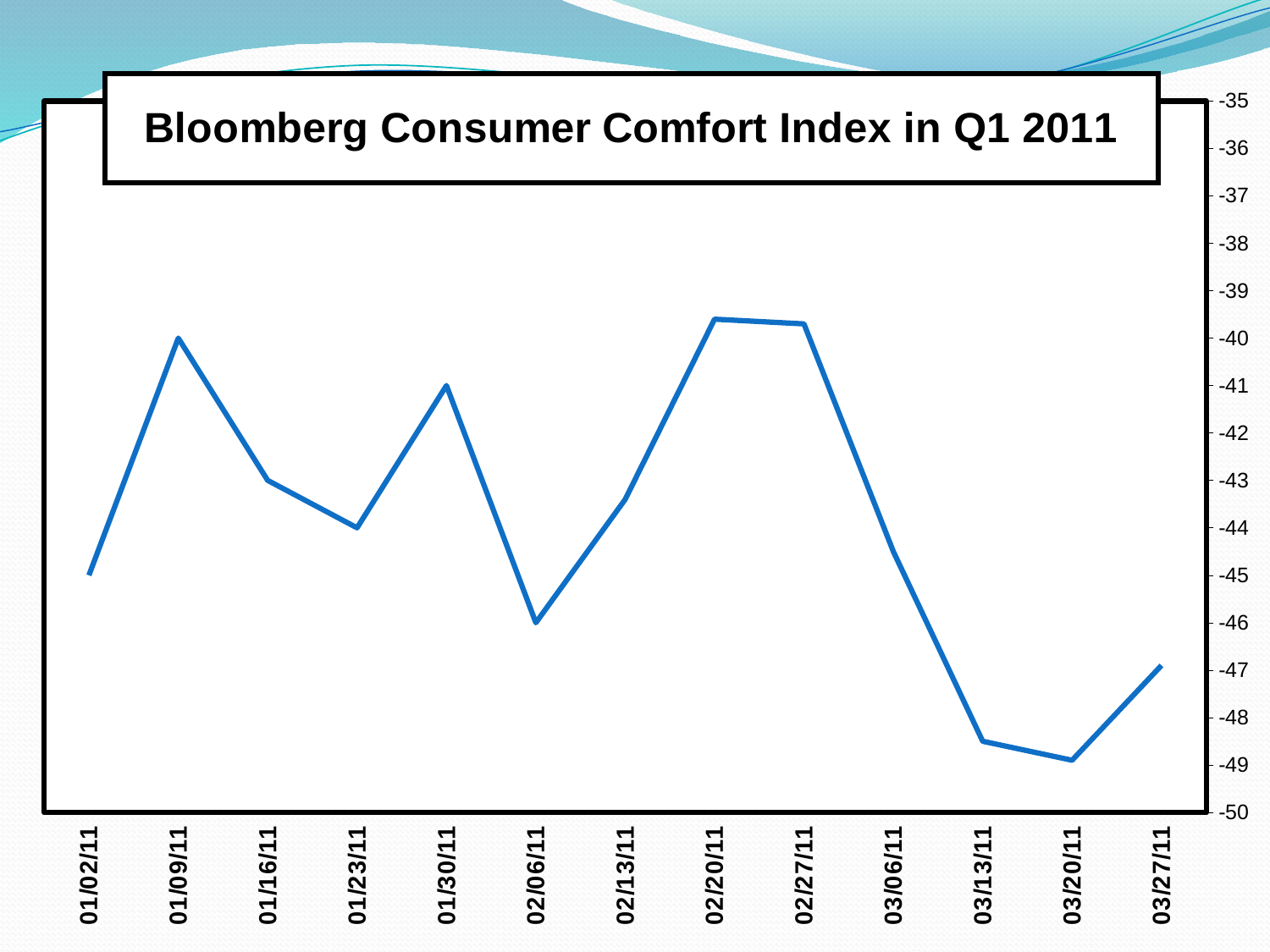
What is the difference between the values for 01/09/11 and 01/02/11? 5 What kind of chart is shown on the slide? line chart What is the index value for 01/30/11? -41 How many dates are plotted along the x axis? 13 Is the value for 02/20/11 greater or less than -40? greater Is the value for 03/13/11 greater or less than -48? less Which is higher, the value for 01/09/11 or the value for 01/30/11? 01/09/11 What is the index value for 01/09/11? -40 What is the title of the chart? Bloomberg Consumer Comfort Index in Q1 2011 What is the index value for 02/06/11? -46 Does the index rise or fall from 02/27/11 to 03/20/11? fall What is the index value for 01/02/11? -45